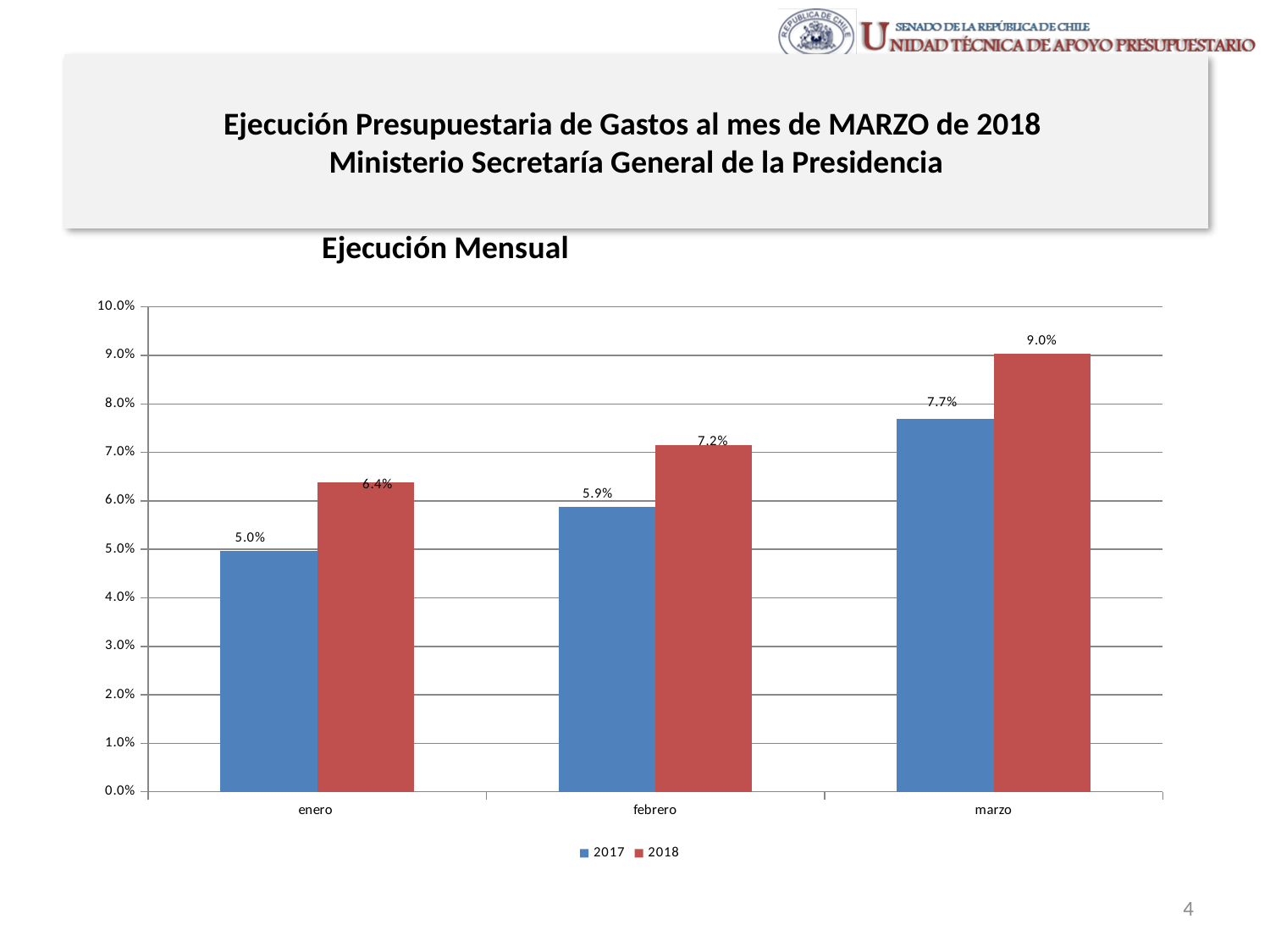
What kind of chart is shown? bar chart Is the value for 2017 in febrero greater or less than 6.0%? less Which month has the lowest value for the 2017 series? enero What is the value for 2017 in enero? 5.0% What is the value for 2018 in febrero? 7.2% How many series does the legend list? 2 What is the value for 2018 in marzo? 9.0% How many months are shown on the x axis? 3 Which month has the highest value for the 2018 series? marzo What is the difference between the 2018 and 2017 values in enero? 1.4% What is the value for 2017 in marzo? 7.7% Which is larger in febrero, the 2017 value or the 2018 value? 2018